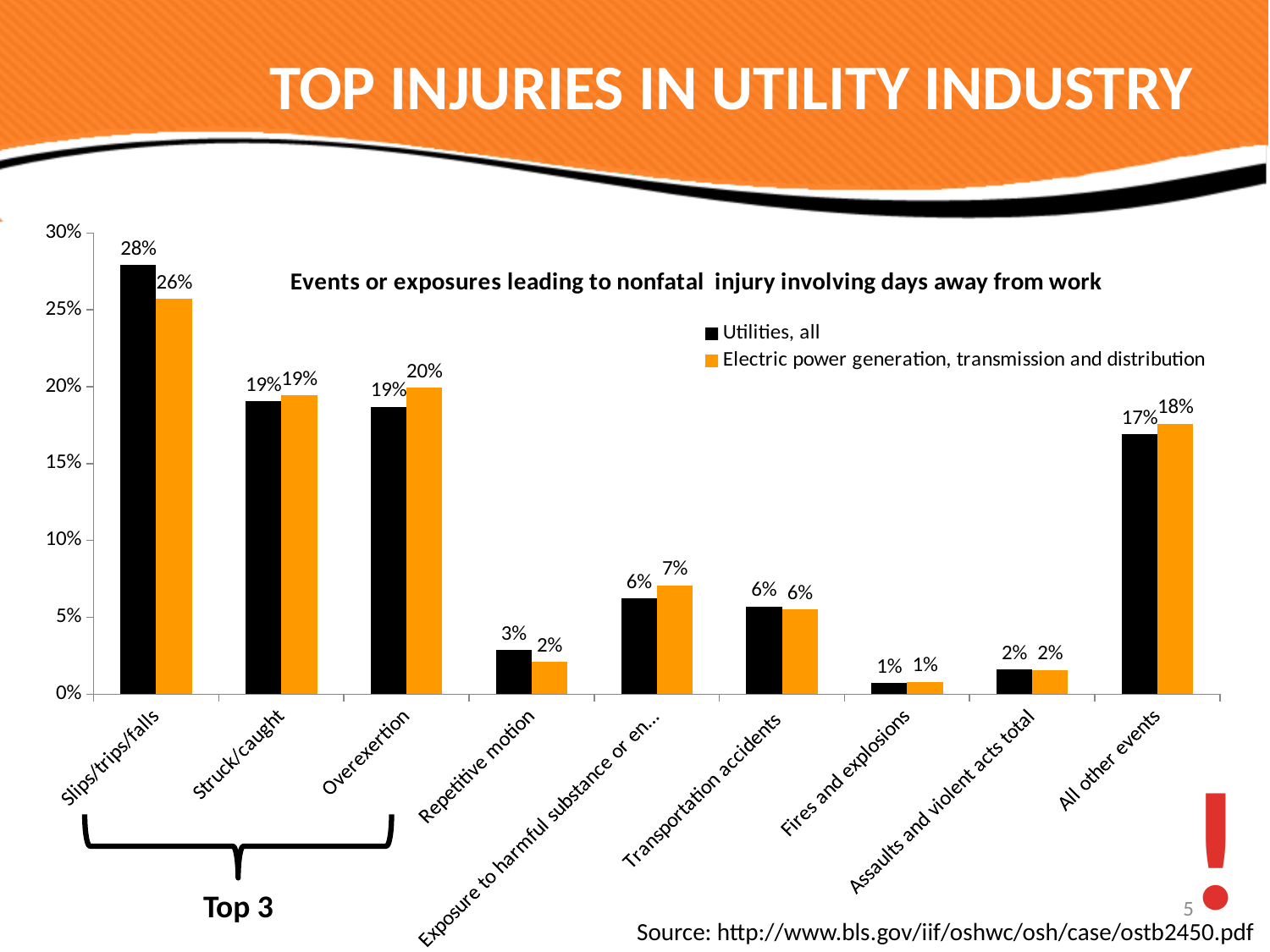
Which category has the highest value in the Utilities, all series? Slips/trips/falls Which category has the lowest value in the Electric power generation, transmission and distribution series? Fires and explosions What is the value for Slips/trips/falls in the Utilities, all series? 28% What is the value for All other events in the Utilities, all series? 17% What is the difference between the Utilities, all value and the Electric power generation, transmission and distribution value for Slips/trips/falls? 2 percentage points What colour represents the Electric power generation, transmission and distribution series? Orange What is the value for Overexertion in the Electric power generation, transmission and distribution series? 20% What kind of chart is shown on the slide? Bar chart How many categories are shown on the x axis? 9 How many series does the legend list? 2 In the Utilities, all series, which is larger: Repetitive motion or Transportation accidents? Transportation accidents What is the value for Slips/trips/falls in the Electric power generation, transmission and distribution series? 26%